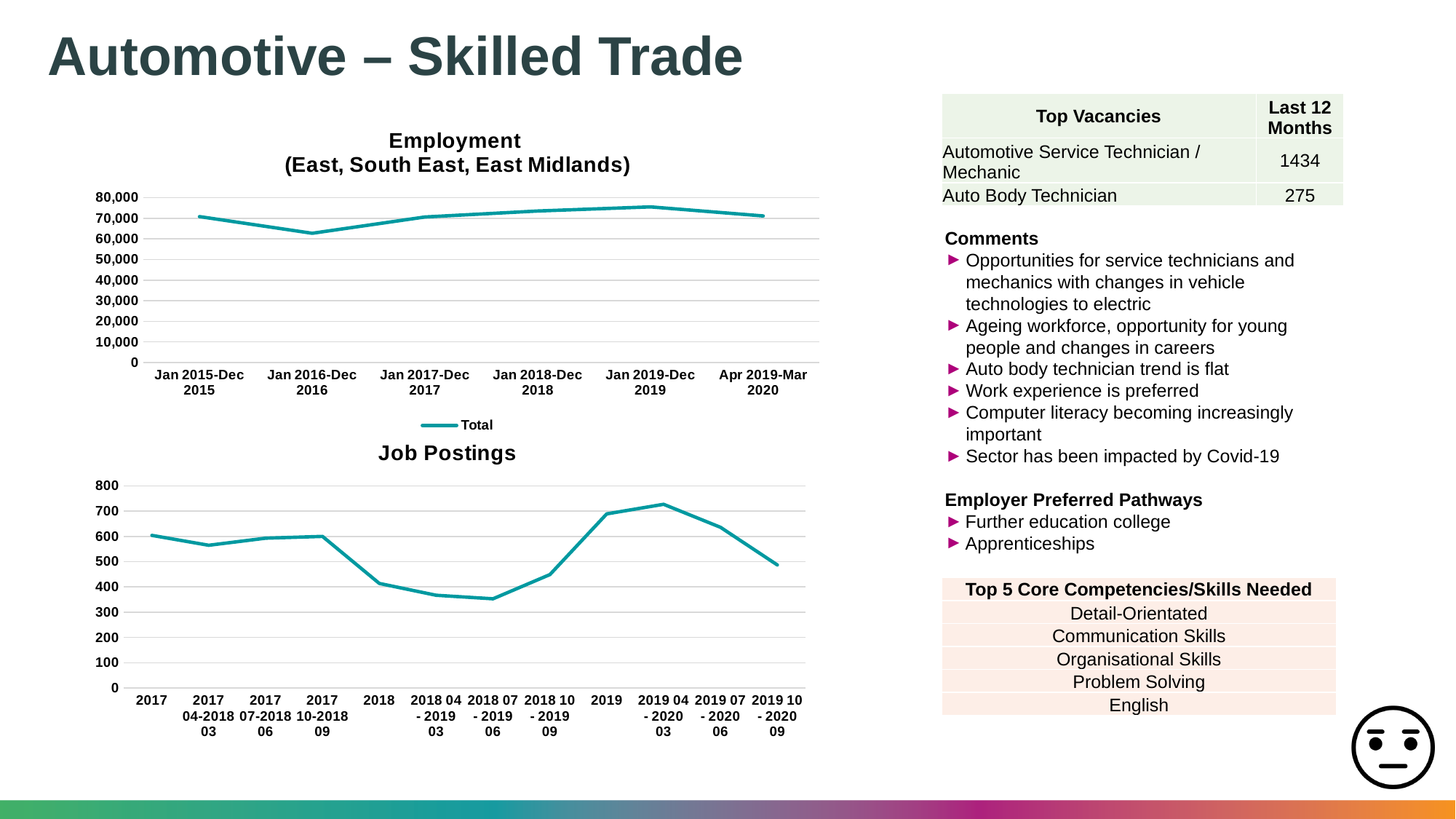
On the Employment (East, South East, East Midlands) chart, is the value for Jan 2016-Dec 2016 greater or less than 60,000? greater How many series does the legend of the Employment (East, South East, East Midlands) chart list? 1 How many time periods are plotted on the Employment (East, South East, East Midlands) chart? 6 On the Employment (East, South East, East Midlands) chart, which period has the lowest employment? Jan 2016-Dec 2016 How many time periods are plotted on the Job Postings chart? 12 On the Job Postings chart, which is larger, the value for 2017 or the value for 2018? 2017 What is the name of the series in the legend of the Employment (East, South East, East Midlands) chart? Total What kind of chart is the Employment (East, South East, East Midlands) chart? line chart On the Job Postings chart, is the value for 2018 04 - 2019 03 greater or less than 400? less On the Job Postings chart, which period has the highest number of job postings? 2019 04 - 2020 03 What kind of chart is the Job Postings chart? line chart On the Employment (East, South East, East Midlands) chart, which period has the highest employment? Jan 2019-Dec 2019